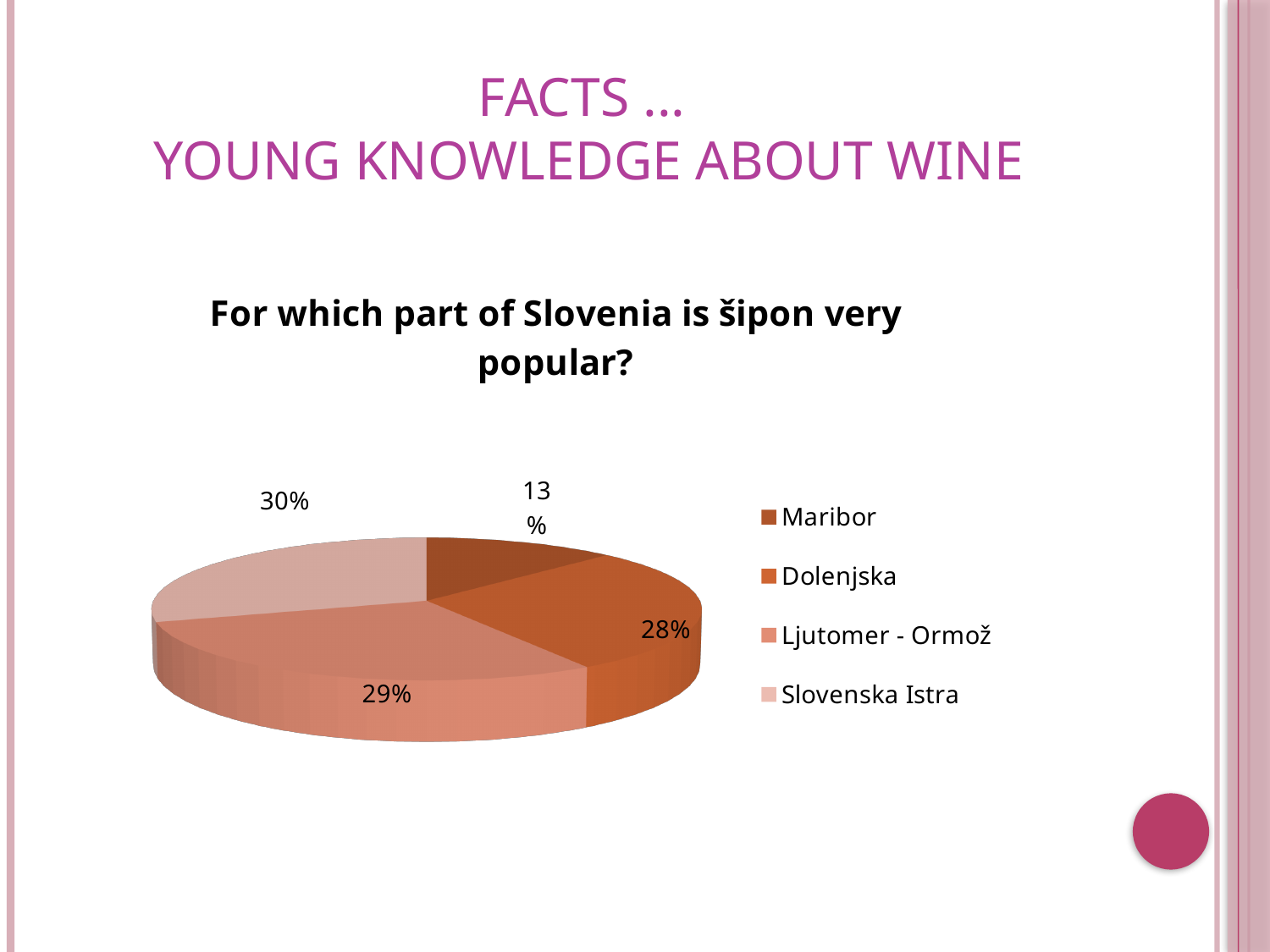
How many regions are shown in the pie chart? 4 What percentage of the pie chart is for Slovenska Istra? 30% Which region has the largest share of the pie chart? Slovenska Istra What percentage of the pie chart is for Dolenjska? 28% What is the title of the chart? For which part of Slovenia is šipon very popular? What percentage of the pie chart is for Ljutomer - Ormož? 29% Which region is listed last in the chart legend? Slovenska Istra Which has a larger share of the pie chart, Dolenjska or Maribor? Dolenjska What type of chart is shown on the slide? Pie chart Which region has the smallest share of the pie chart? Maribor What percentage of the pie chart is for Maribor? 13% What is the difference in percentage points between the Slovenska Istra share and the Maribor share? 17